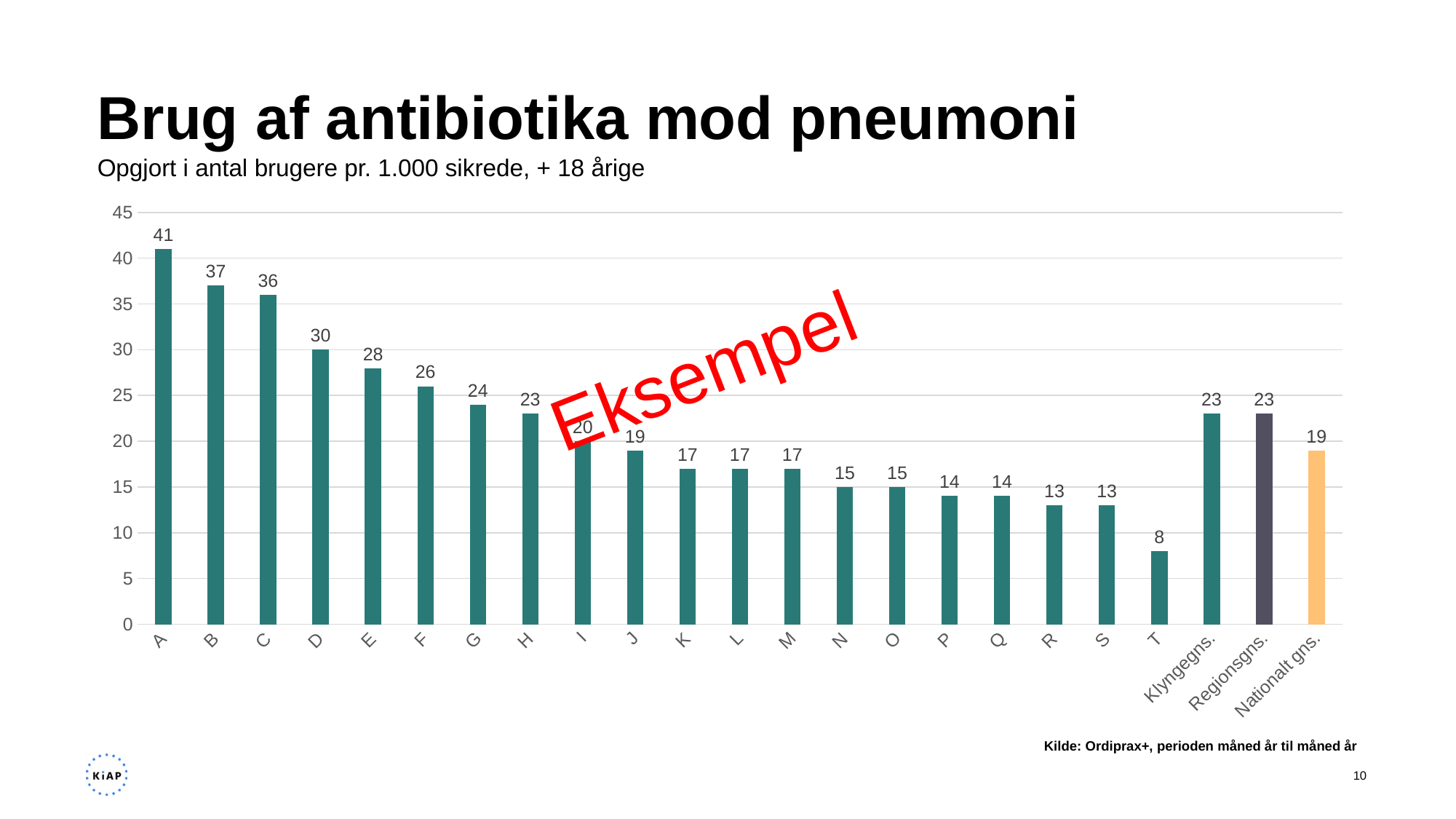
What is the value for Nationalt gns.? 19 What is the value for category T? 8 Is the value for category C greater or less than 35? greater What is the value for category A? 41 What kind of chart is shown on the slide? bar chart Which category has the lowest value? T Do the values for categories A through T rise or fall from left to right? fall How many bars are shown in the chart? 23 Which category has the highest value? A What is the difference between Klyngegns. and Nationalt gns.? 4 What is the difference between the values for A and B? 4 Which is larger, the value for D or the value for E? D